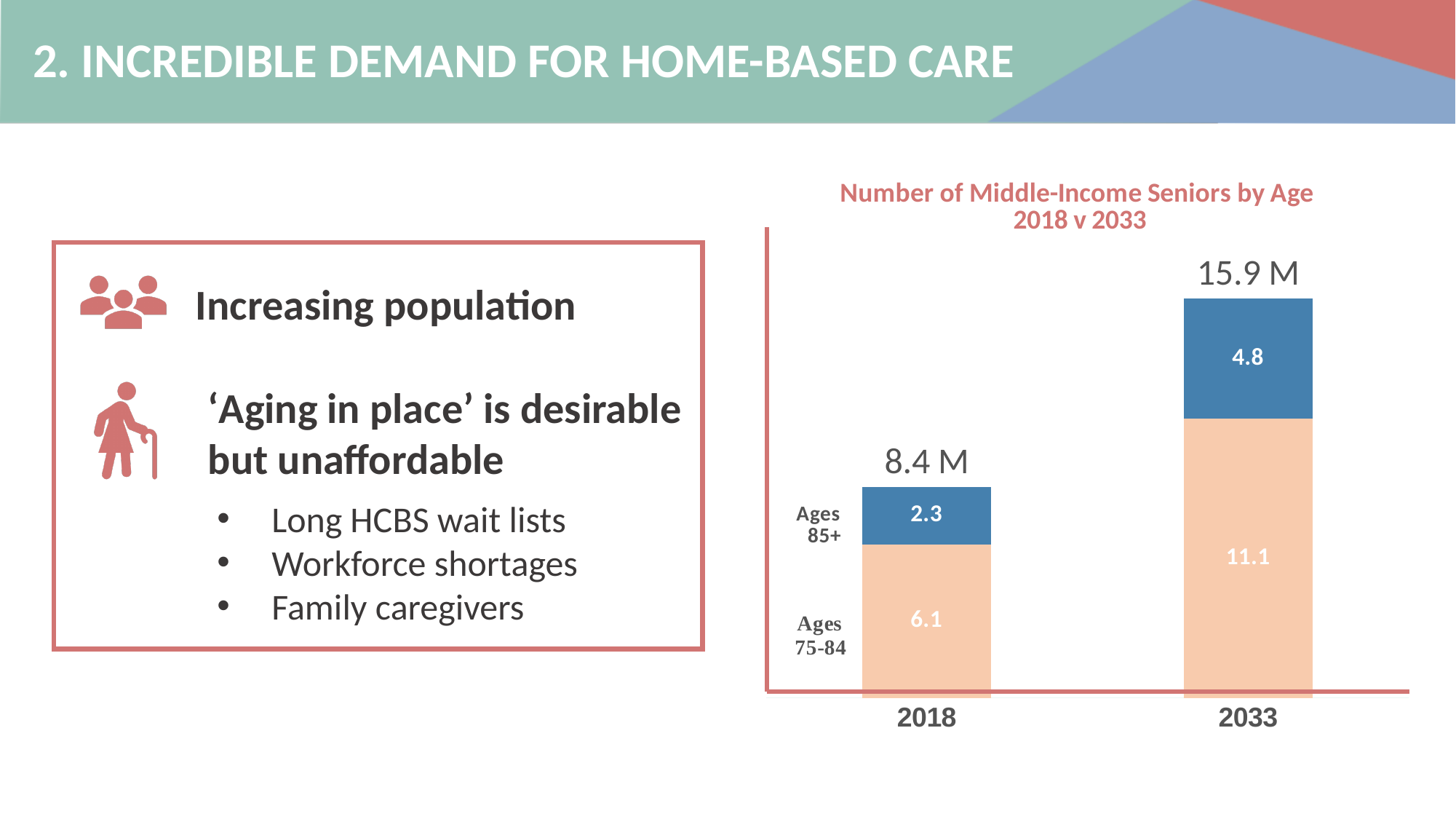
What is the difference between the Ages 75-84 values for 2033 and 2018? 5.0 What is the value for Ages 85+ in 2033? 4.8 Which year has the larger total of middle-income seniors, 2018 or 2033? 2033 What is the value for Ages 75-84 in 2018? 6.1 What is the total shown above the 2033 bar? 15.9 M What is the value for Ages 75-84 in 2033? 11.1 What is the value for Ages 85+ in 2018? 2.3 What is the total shown above the 2018 bar? 8.4 M What is the difference between the Ages 85+ values for 2033 and 2018? 2.5 What is the title of the chart? Number of Middle-Income Seniors by Age 2018 v 2033 What kind of chart is shown on the slide? Stacked bar chart How many years (categories) are shown on the x axis? 2